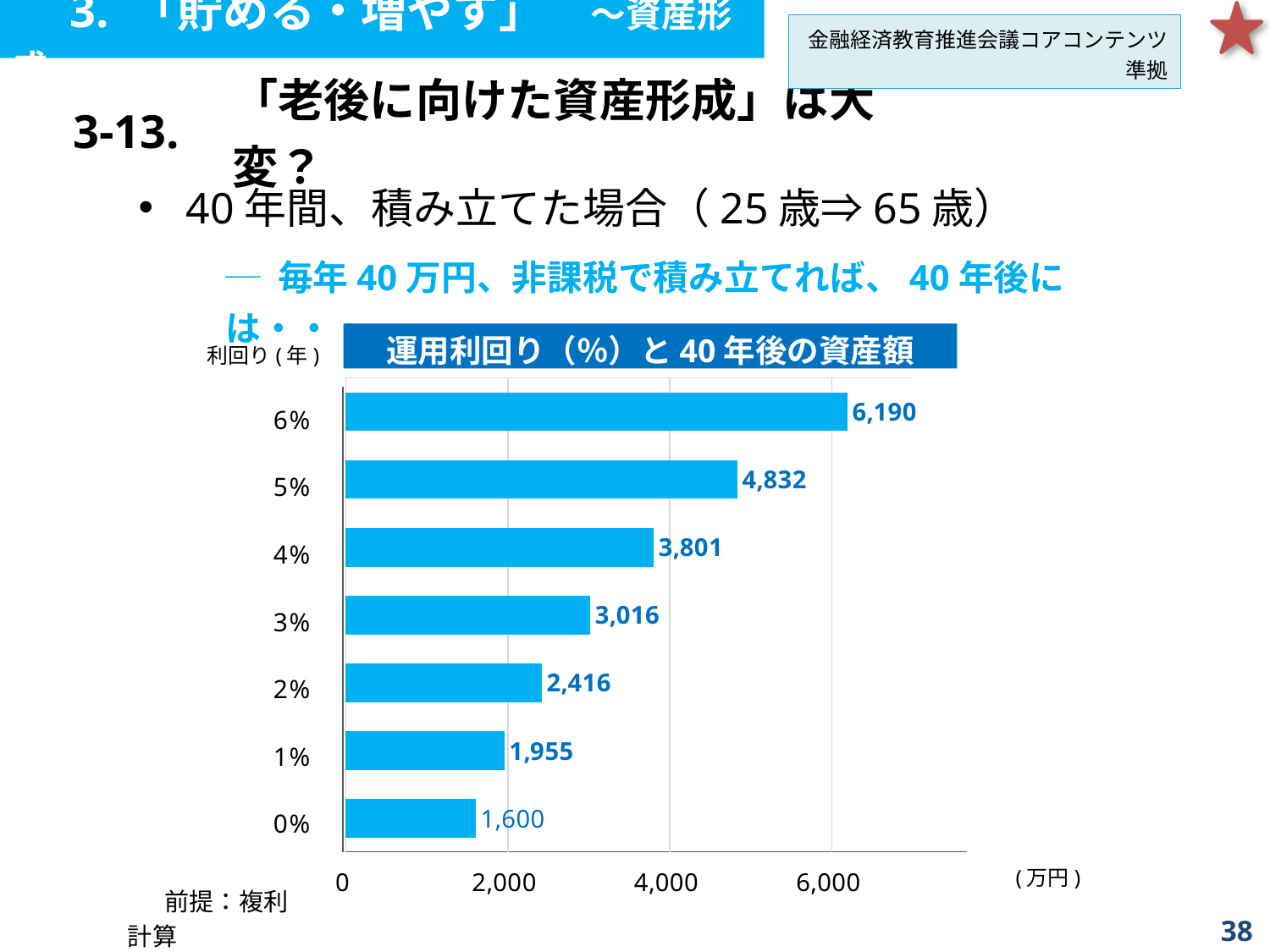
Is the value for 5% greater or less than 4,000? greater What kind of chart is shown on the slide? bar chart What is the difference between the values for 6% and 5%? 1,358 How many categories are shown in the chart? 7 What is the value for 3% in the chart? 3,016 Which category has the highest value in the chart? 6% What is the value for 6% in the chart? 6,190 What is the value for 0% in the chart? 1,600 What is the difference between the values for 2% and 1%? 461 Which is larger, the value for 4% or the value for 3%? 4% Which category has the lowest value in the chart? 0% What is the title of the chart? 運用利回り（%）と40年後の資産額